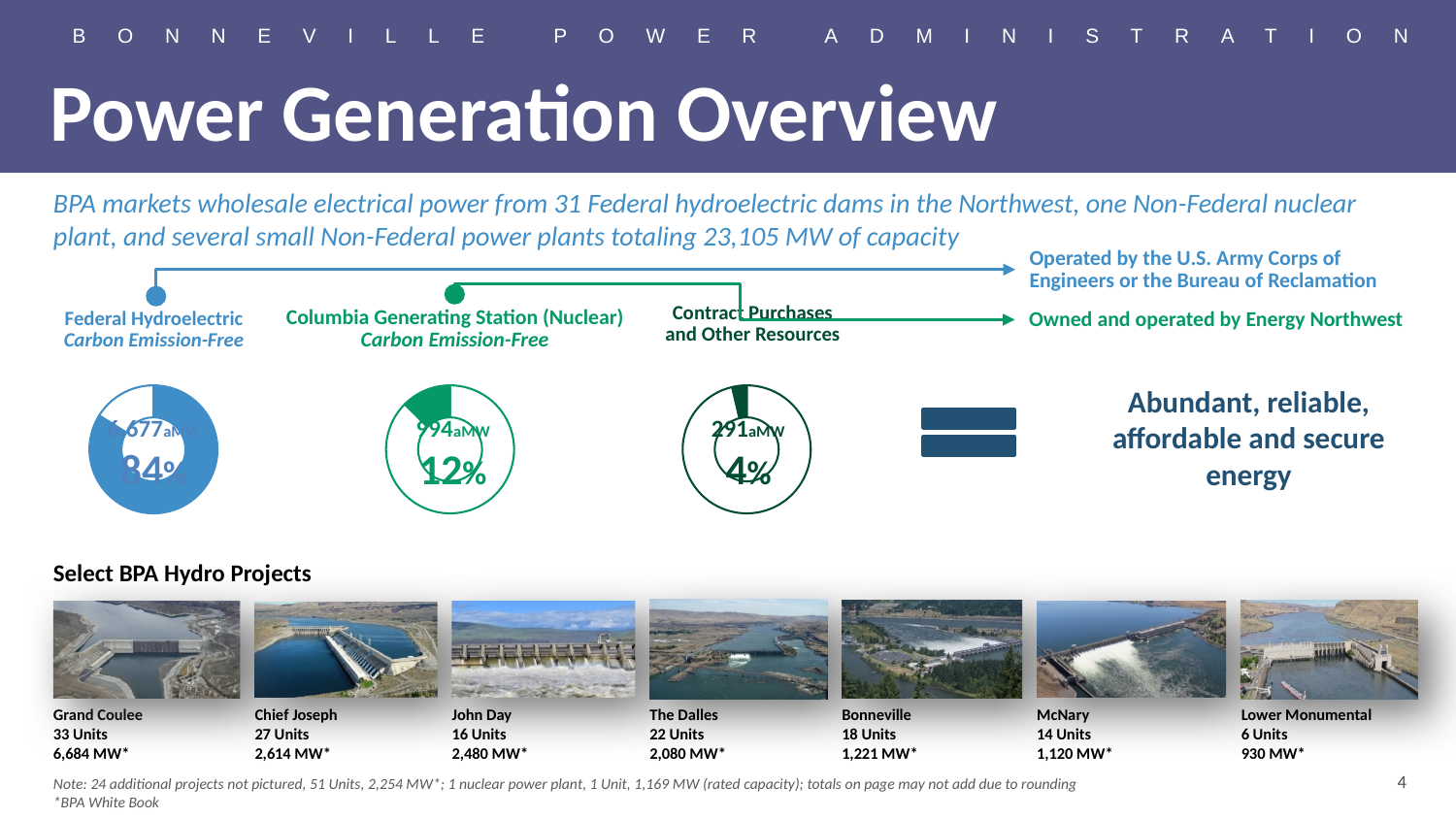
Which of the three charts shows the largest percentage share? Federal Hydroelectric What value in aMW is shown in the Columbia Generating Station (Nuclear) chart? 994 aMW What kind of chart is used to show the Federal Hydroelectric share? Doughnut chart What percentage is shown in the Contract Purchases and Other Resources chart? 4% What percentage is shown in the Columbia Generating Station (Nuclear) chart? 12% Which of the three charts shows the smallest percentage share? Contract Purchases and Other Resources What is the difference in aMW between the Columbia Generating Station (Nuclear) chart and the Contract Purchases and Other Resources chart? 703 aMW Which is larger, the Columbia Generating Station (Nuclear) share or the Contract Purchases and Other Resources share? Columbia Generating Station (Nuclear) What is the difference in percentage points between the Columbia Generating Station (Nuclear) share and the Contract Purchases and Other Resources share? 8 percentage points What percentage is shown in the Federal Hydroelectric chart? 84% What value in aMW is shown in the Contract Purchases and Other Resources chart? 291 aMW